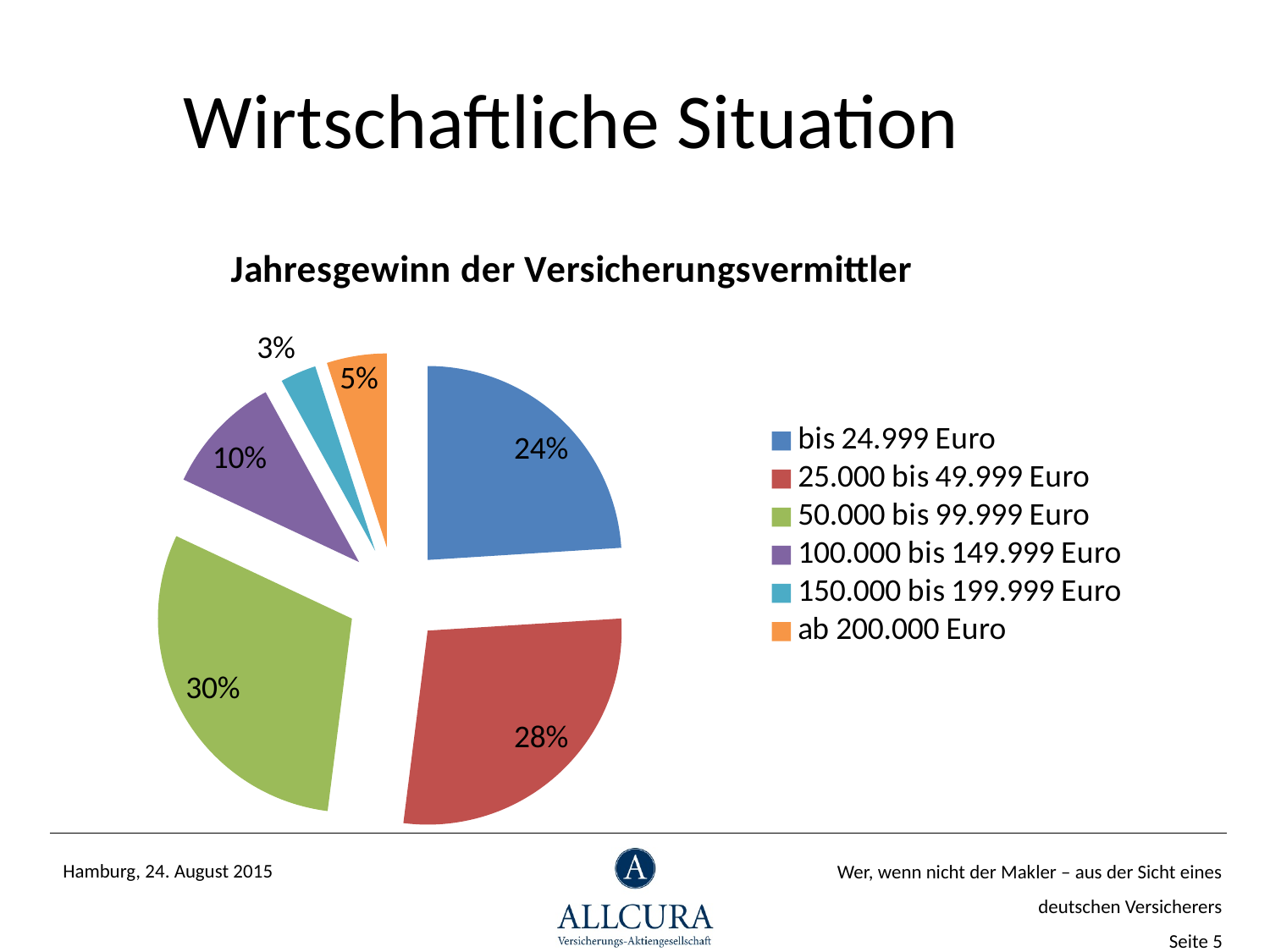
How many categories does the legend list? 6 What is the value shown for '150.000 bis 199.999 Euro'? 3% What is the value shown for 'ab 200.000 Euro'? 5% What is the value shown for '50.000 bis 99.999 Euro'? 30% Which category has the smallest slice of the pie? 150.000 bis 199.999 Euro What is the difference between the values for '50.000 bis 99.999 Euro' and 'bis 24.999 Euro'? 6% What is the title of the chart? Jahresgewinn der Versicherungsvermittler What share of the pie does the 'bis 24.999 Euro' slice represent? 24% What kind of chart is shown on the slide? pie chart What is the value shown for '25.000 bis 49.999 Euro'? 28% What is the value shown for '100.000 bis 149.999 Euro'? 10% Which category has the largest slice of the pie? 50.000 bis 99.999 Euro